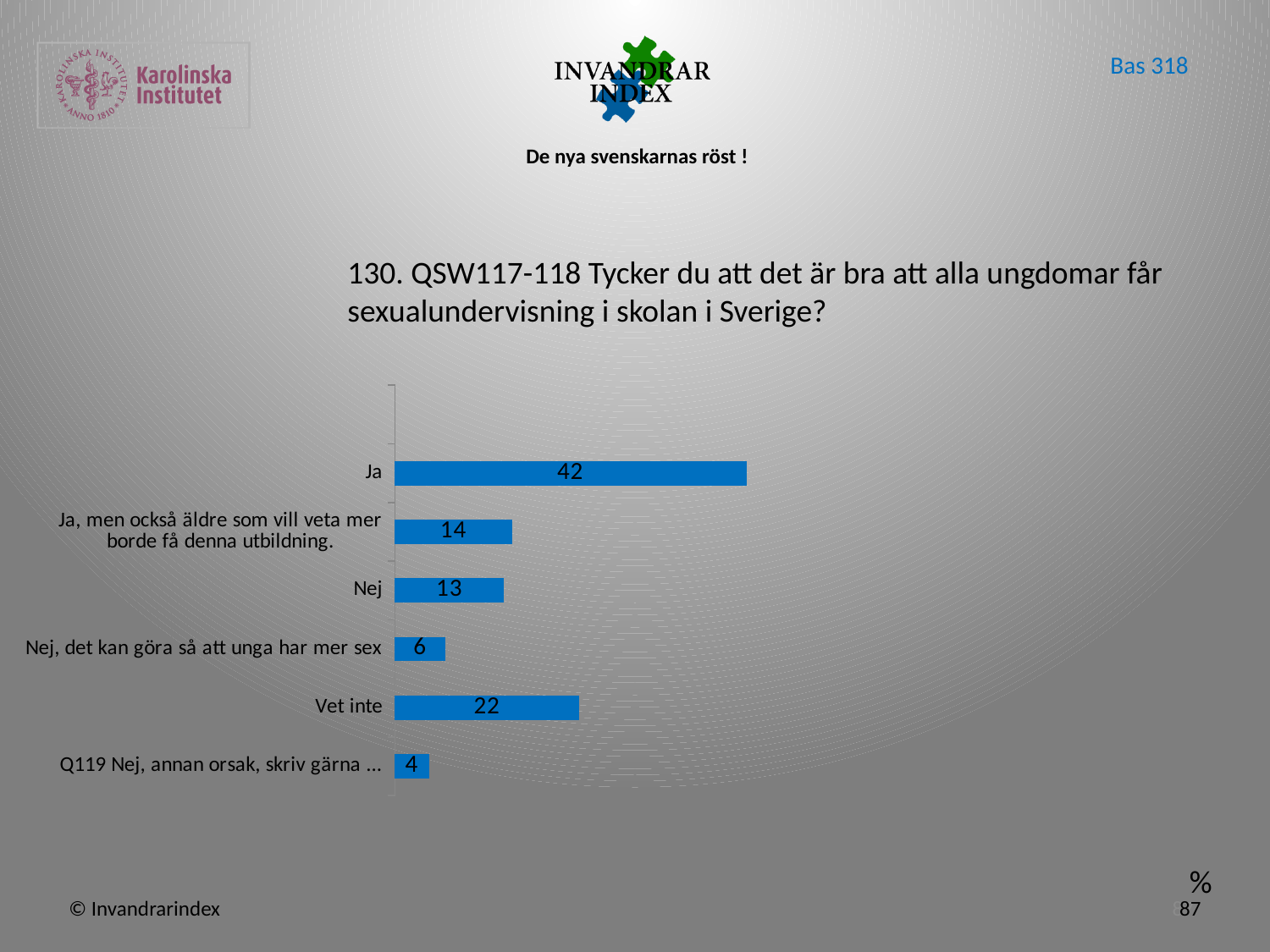
What is the base (Bas) shown on the slide? 318 What is the value for "Ja, men också äldre som vill veta mer borde få denna utbildning."? 14 What is the difference between the values for "Ja" and "Vet inte"? 20 Which is larger, the value for "Nej" or the value for "Vet inte"? Vet inte Which category has the lowest value? Q119 Nej, annan orsak, skriv gärna ... What is the value for "Nej, det kan göra så att unga har mer sex"? 6 What is the value for "Nej"? 13 How many categories are shown in the chart? 6 What kind of chart is shown on the slide? Bar chart Which category has the highest value? Ja What is the value for "Ja"? 42 What is the value for "Vet inte"? 22